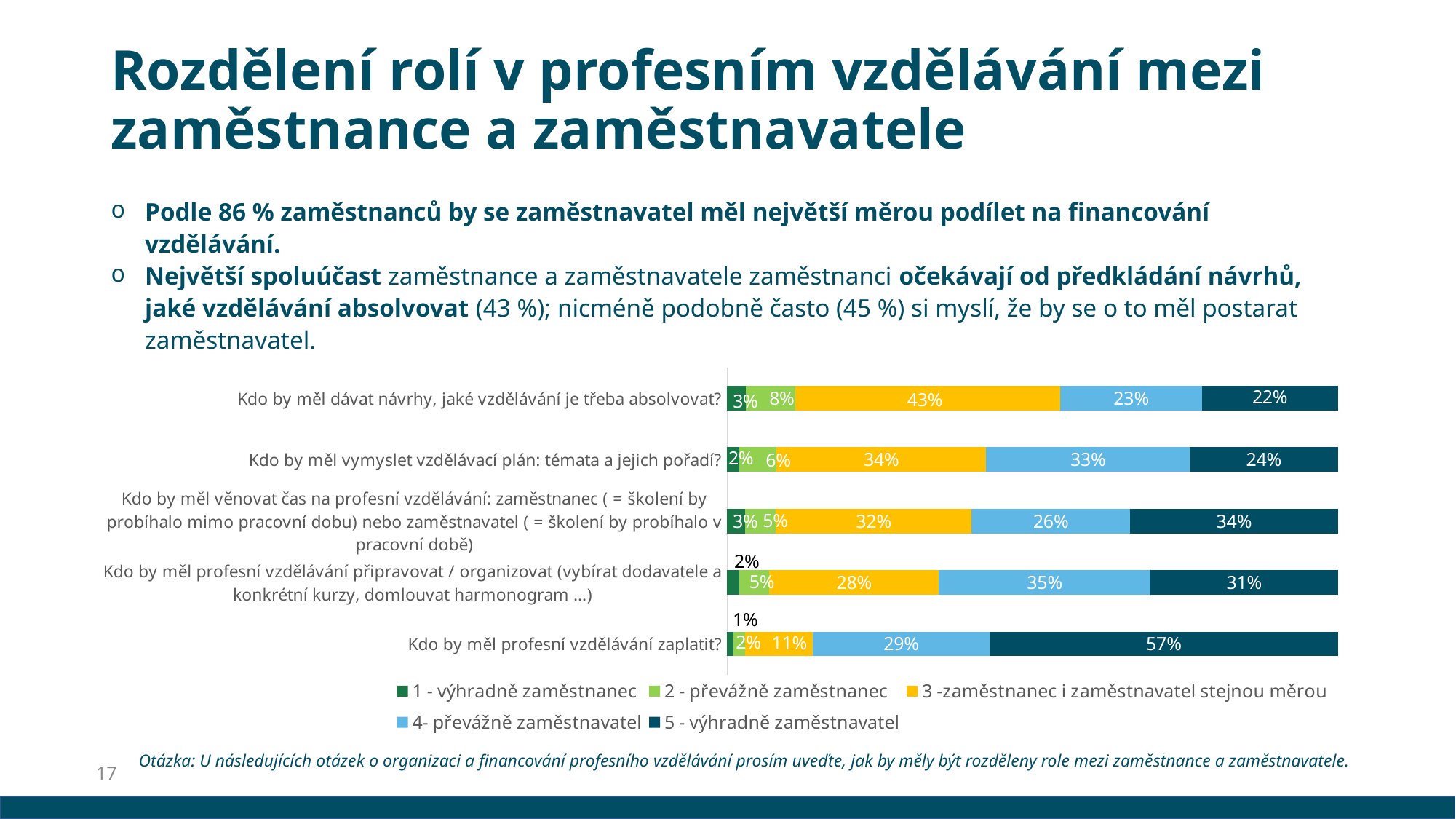
Which category has the highest value for '5 - výhradně zaměstnavatel'? Kdo by měl profesní vzdělávání zaplatit? For 'Kdo by měl profesní vzdělávání připravovat / organizovat', which is larger: '4- převážně zaměstnavatel' or '5 - výhradně zaměstnavatel'? 4- převážně zaměstnavatel How many categories (questions) are plotted in the chart? 5 What is the value of '3 -zaměstnanec i zaměstnavatel stejnou měrou' for 'Kdo by měl dávat návrhy, jaké vzdělávání je třeba absolvovat?'? 43% What is the value of '2 - převážně zaměstnanec' for 'Kdo by měl profesní vzdělávání zaplatit?'? 2% What is the value of '4- převážně zaměstnavatel' for 'Kdo by měl vymyslet vzdělávací plán: témata a jejich pořadí?'? 33% What is the difference between the '5 - výhradně zaměstnavatel' values for 'Kdo by měl profesní vzdělávání zaplatit?' and 'Kdo by měl dávat návrhy, jaké vzdělávání je třeba absolvovat?'? 35% How many series does the chart legend list? 5 What is the value of '5 - výhradně zaměstnavatel' for 'Kdo by měl profesní vzdělávání zaplatit?'? 57% What is the combined value of '4- převážně zaměstnavatel' and '5 - výhradně zaměstnavatel' for 'Kdo by měl profesní vzdělávání zaplatit?'? 86% What kind of chart is shown on the slide? stacked bar chart Which category has the lowest value for '3 -zaměstnanec i zaměstnavatel stejnou měrou'? Kdo by měl profesní vzdělávání zaplatit?